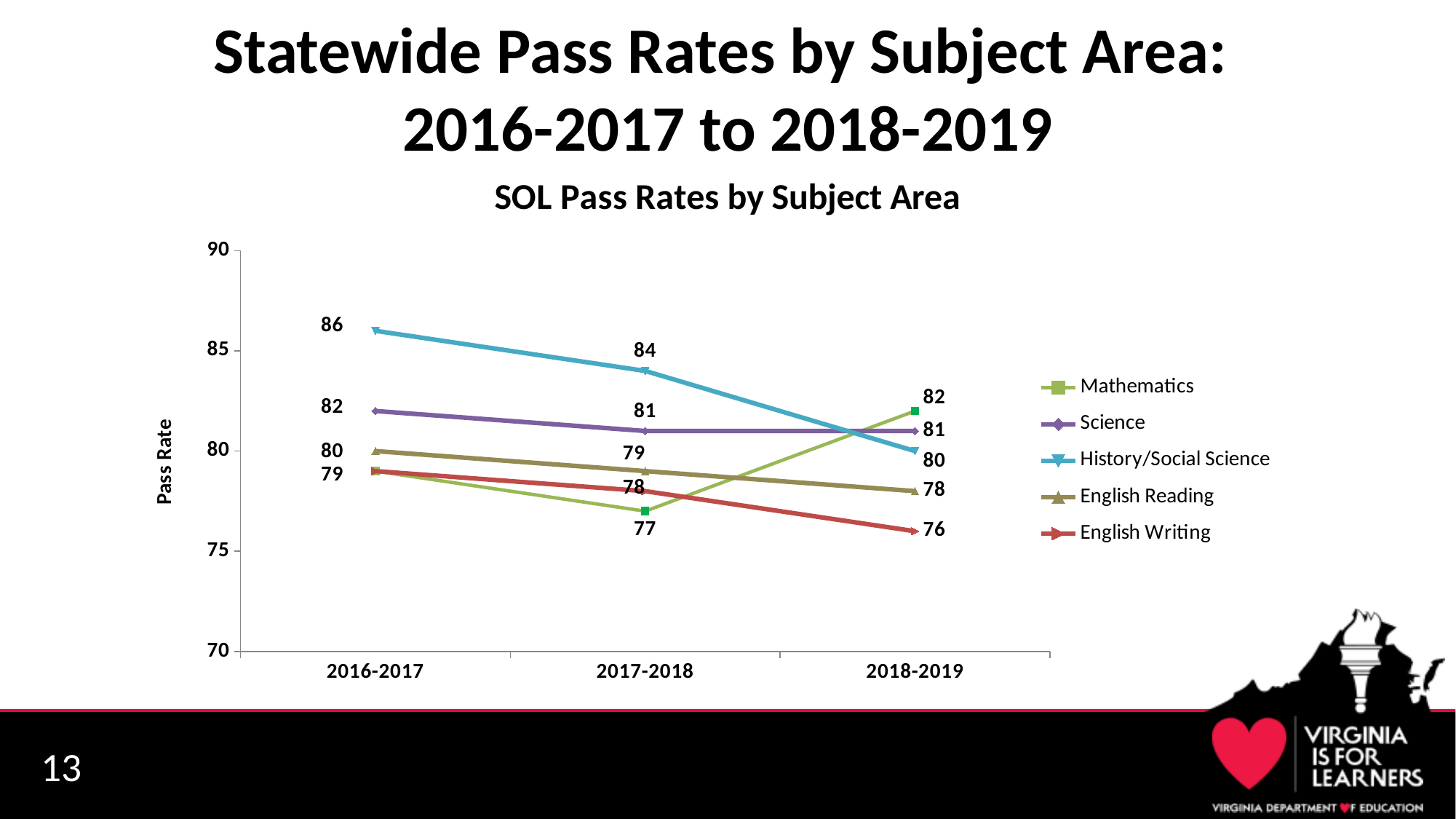
What is the Science pass rate for 2017-2018? 81 Which subject area had the highest pass rate in 2016-2017? History/Social Science Which subject area had the lowest pass rate in 2018-2019? English Writing What is the History/Social Science pass rate for 2016-2017? 86 By how much did the History/Social Science pass rate fall from 2016-2017 to 2018-2019? 6 How many school years are shown on the x axis? 3 What is the English Writing pass rate for 2018-2019? 76 How many series does the legend list? 5 What kind of chart is shown on the slide? line chart In 2018-2019, which is higher: the Mathematics pass rate or the History/Social Science pass rate? Mathematics What is the Mathematics pass rate for 2018-2019? 82 Does the English Reading pass rate rise or fall from 2016-2017 to 2018-2019? fall